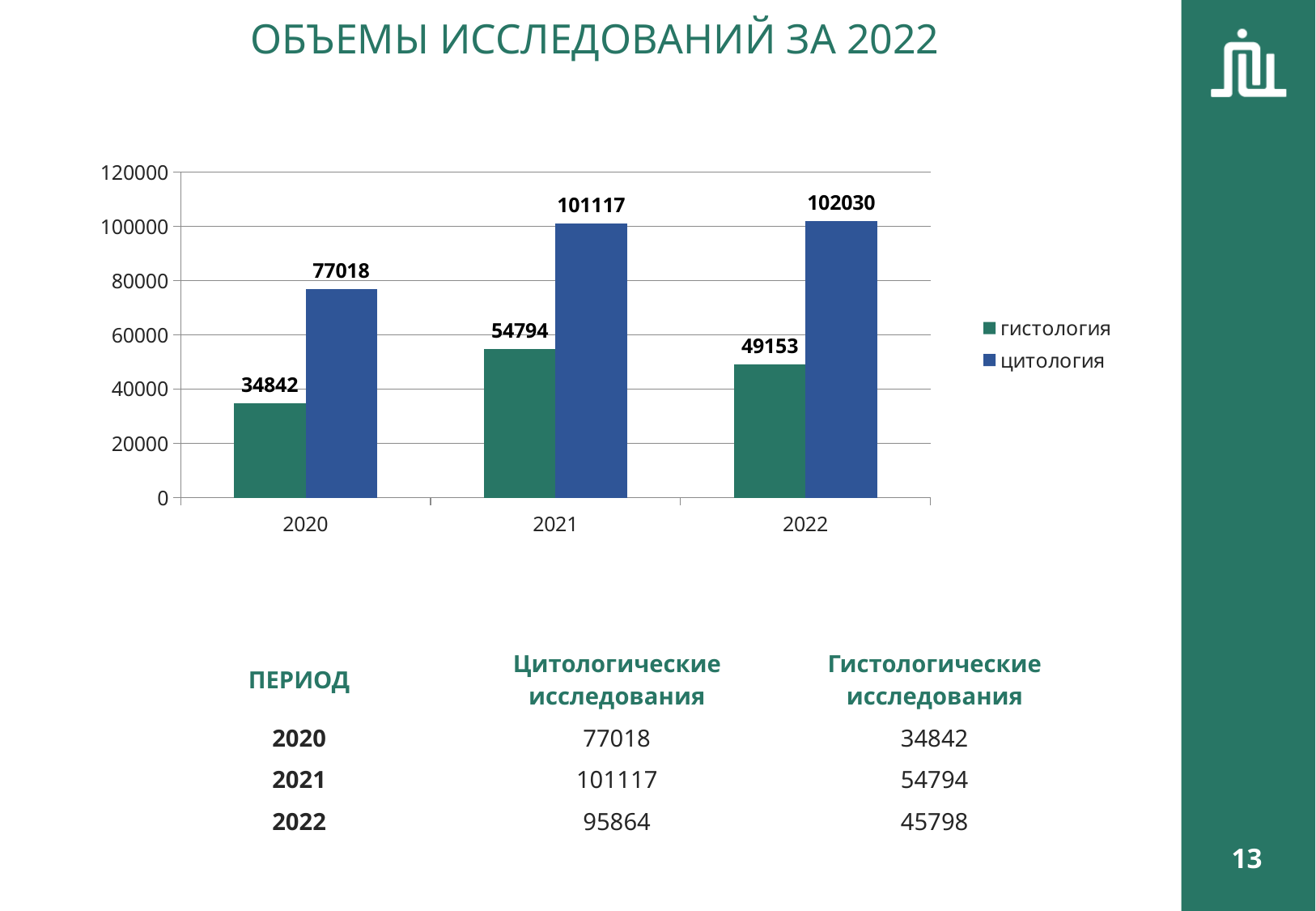
What is the value for гистология in 2020? 34842 In which year is the гистология value lowest? 2020 Which is larger in 2021: гистология or цитология? цитология What is the value for цитология in 2021? 101117 How many series does the legend list? 2 What kind of chart is shown on the slide? bar chart What is the difference between the цитология and гистология values in 2022? 52877 In which year is the цитология value highest? 2022 How many years are shown on the x axis? 3 Does the цитология value rise or fall from 2020 to 2022? rise What is the value for гистология in 2022? 49153 What is the value for цитология in 2020? 77018